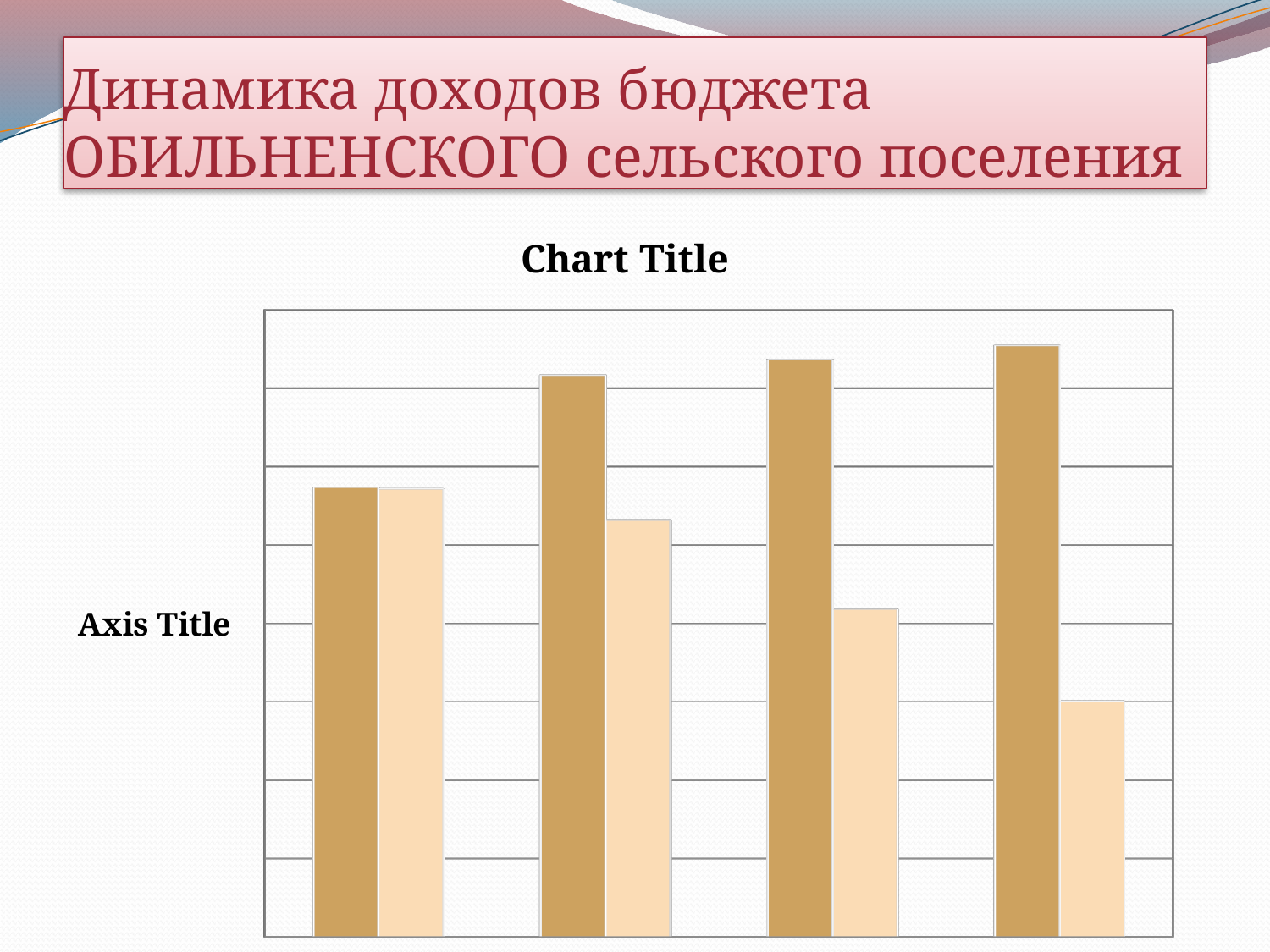
In the second group from the left, which bar is taller, the darker one or the lighter one? the darker one How many groups of bars does the chart contain? 4 Do the lighter (beige) bars rise or fall from left to right across the chart? fall How many bars are in each group of the chart? 2 Do the darker (tan) bars rise or fall from left to right across the chart? rise In the rightmost group of bars, which bar is taller, the darker one or the lighter one? the darker one What text is shown as the vertical axis title of the chart? Axis Title What kind of chart is shown on the slide? bar chart What is the title printed above the chart? Chart Title